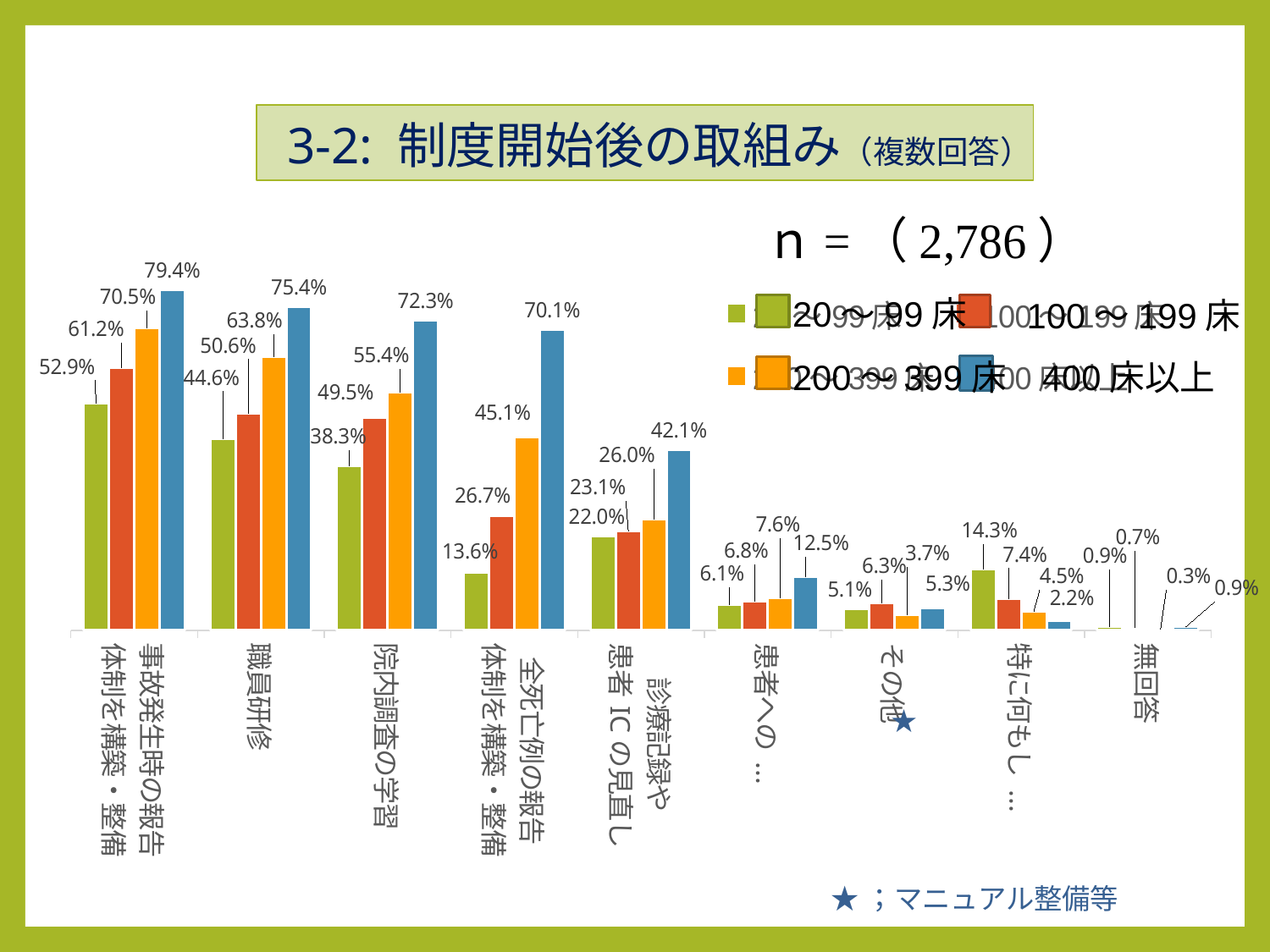
What is the value for 100～199床 in the 無回答 category? 0.7% How many categories are shown on the x axis? 9 Which series has the lowest value in the 無回答 category? 200～399床 What is the value for 400床以上 in the 職員研修 category? 75.4% What is the sample size (n) stated on the slide? 2,786 What type of chart is shown on the slide? bar chart How many series does the legend list? 4 In the その他 category, which is larger: the value for 100～199床 or the value for 200～399床? 100～199床 Which series has the highest value in the 院内調査の学習 category? 400床以上 What is the value for 20～99床 in the 院内調査の学習 category? 38.3% What is the value for 200～399床 in the 職員研修 category? 63.8% What is the difference between the 400床以上 and 20～99床 values in the 職員研修 category? 30.8%